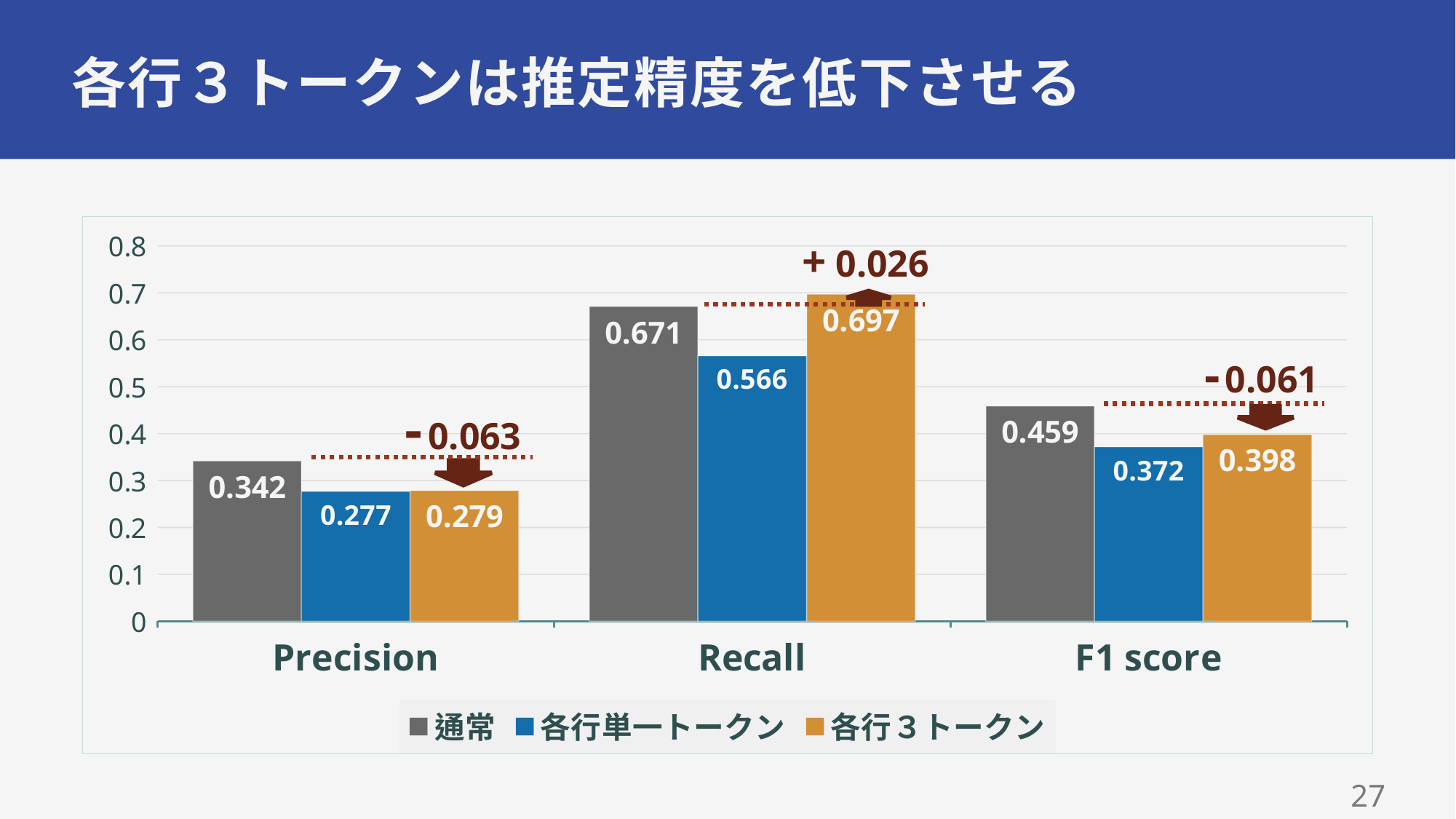
What is the Precision value for the 通常 series? 0.342 What is the Recall value for the 各行単一トークン series? 0.566 How many series does the legend list? 3 For Recall, which is larger: the 通常 value or the 各行３トークン value? 各行３トークン Is the Recall value for 通常 greater or less than 0.6? greater Which category has the highest value for the 通常 series? Recall How many categories are shown on the x axis? 3 What kind of chart is shown on the slide? bar chart What colour are the bars for the 各行３トークン series? orange What is the difference between the 通常 and 各行３トークン values for F1 score? 0.061 What is the F1 score value for the 各行３トークン series? 0.398 Which category has the lowest value for the 各行単一トークン series? Precision